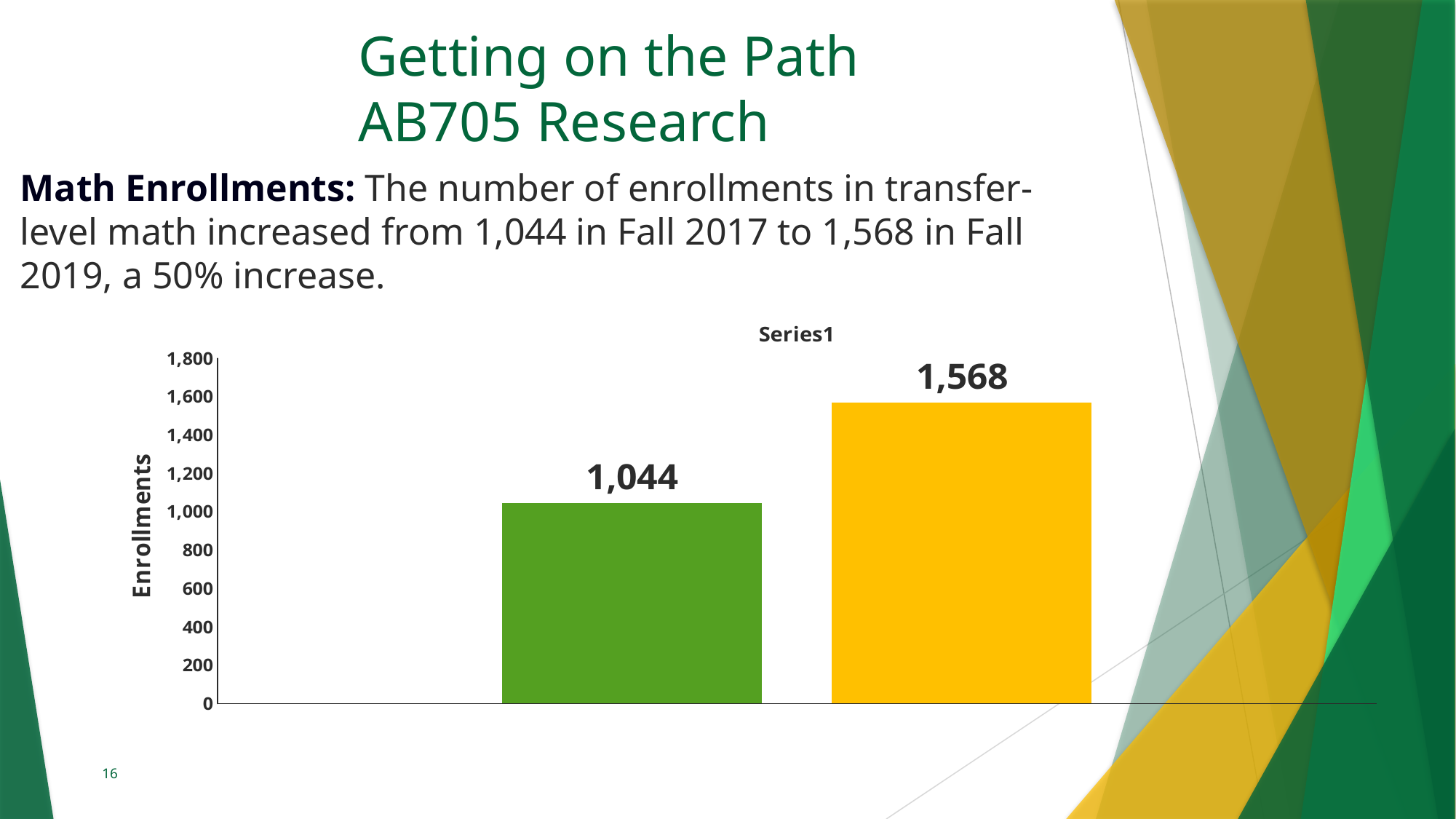
Is the value of the green bar greater or less than 1,200? less Is the value of the yellow bar greater or less than 1,400? greater What is the label on the vertical axis of the chart? Enrollments What is the difference between the values of the yellow bar and the green bar? 524 What is the title shown above the chart? Series1 What kind of chart is shown on the slide? bar chart Do the bar values rise or fall from left to right? rise Which bar has the higher value, the left (green) bar or the right (yellow) bar? the right (yellow) bar How many bars are plotted in the chart? 2 Which bar has the lower value, the green bar or the yellow bar? the green bar What value is shown on the yellow bar in the chart? 1,568 What value is shown on the green bar in the chart? 1,044